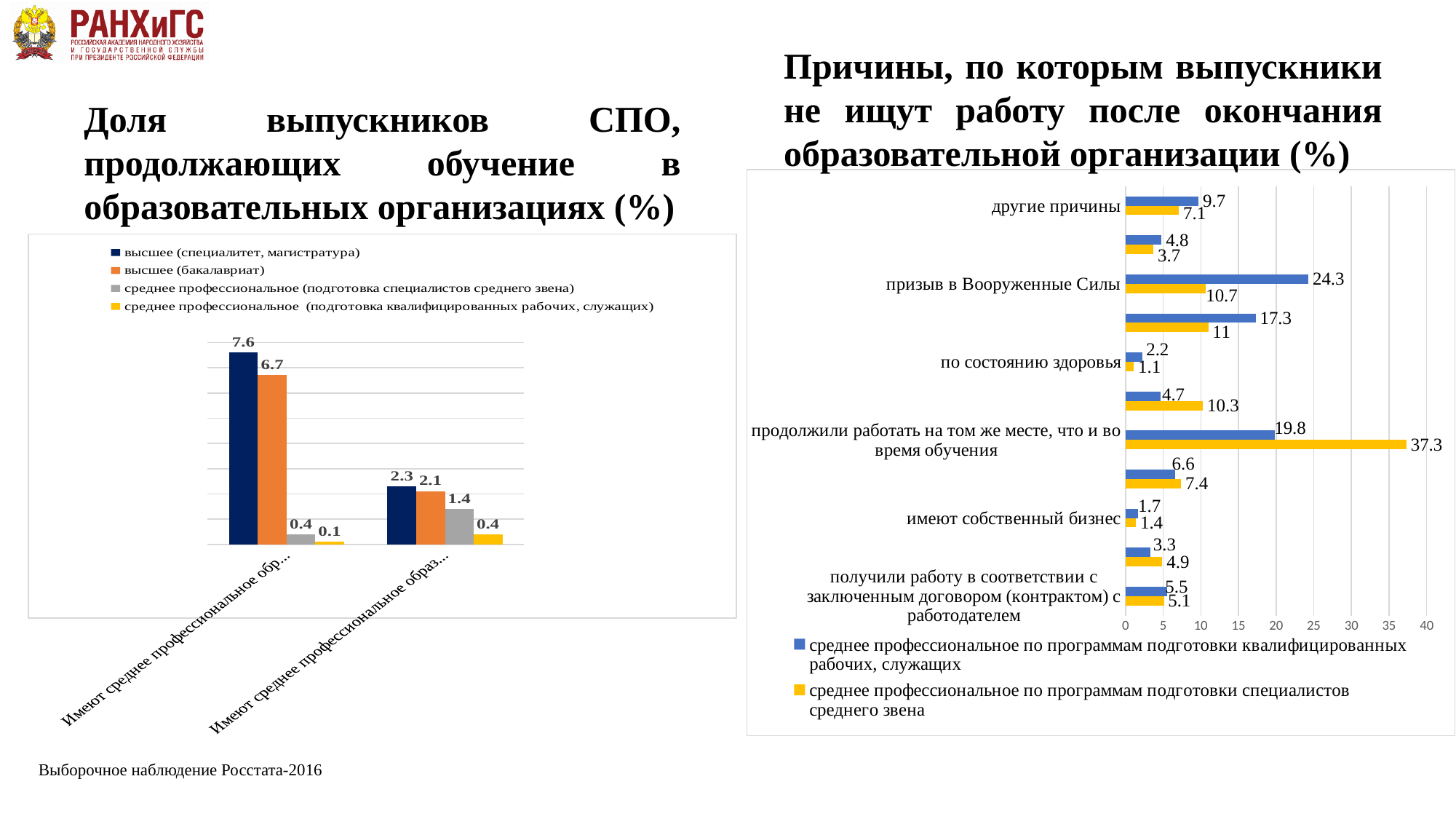
On the left chart, what is the difference between the dark blue and orange values in the first (left) group of bars? 0.9 What type of chart is the right chart (Причины, по которым выпускники не ищут работу)? bar chart On the right chart, which category has the highest value for the yellow series (подготовка специалистов среднего звена)? продолжили работать на том же месте, что и во время обучения On the left chart (Доля выпускников СПО, продолжающих обучение), what is the value of the dark blue series (высшее (специалитет, магистратура)) for the first (left) group of bars? 7.6 On the left chart, what is the value of the orange series (высшее (бакалавриат)) for the second (right) group of bars? 2.1 On the left chart, what is the value of the yellow series (среднее профессиональное (подготовка квалифицированных рабочих, служащих)) for the first (left) group of bars? 0.1 On the right chart (Причины, по которым выпускники не ищут работу), what is the value for 'призыв в Вооруженные Силы' for the blue series (подготовка квалифицированных рабочих, служащих)? 24.3 On the right chart, what is the value for 'продолжили работать на том же месте, что и во время обучения' for the yellow series (подготовка специалистов среднего звена)? 37.3 On the left chart, how many series does the legend list? 4 On the right chart, what is the difference between the blue and yellow values for 'по состоянию здоровья'? 1.1 On the right chart, which is larger for 'имеют собственный бизнес': the blue series or the yellow series? the blue series (1.7) On the left chart, which series has the highest value in the second (right) group of bars? высшее (специалитет, магистратура)